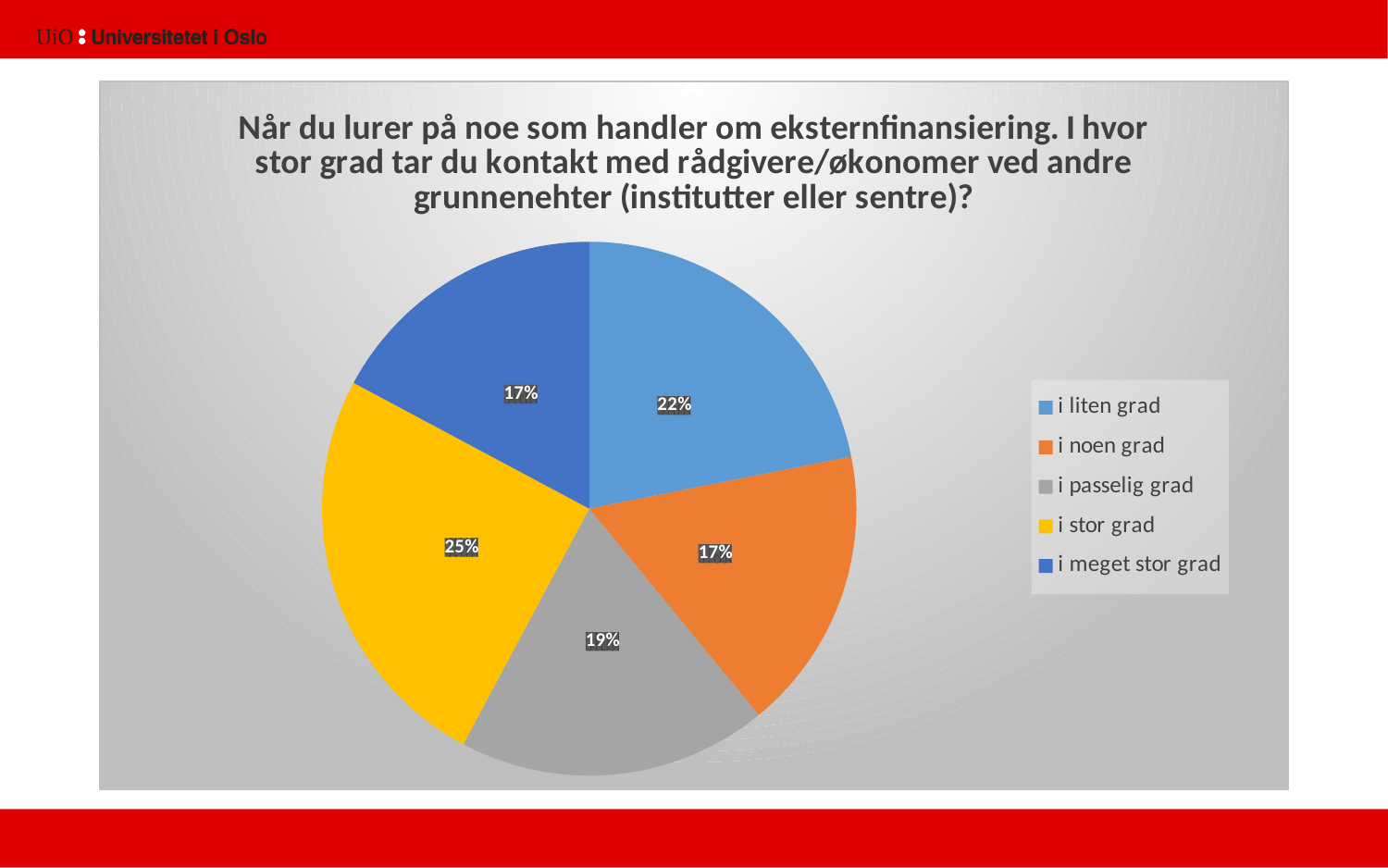
Which colour represents "i stor grad" in the pie chart? yellow How many categories does the pie chart have? 5 What type of chart is shown on the slide? pie chart What share of the pie does "i stor grad" represent? 25% What share of the pie does "i noen grad" represent? 17% What is the difference in percentage points between the share for "i stor grad" and the share for "i noen grad"? 8 percentage points Which is larger: the share for "i liten grad" or the share for "i passelig grad"? i liten grad Which category has the largest share of the pie? i stor grad Which legend entry is listed last in the legend? i meget stor grad What share of the pie does "i liten grad" represent? 22%